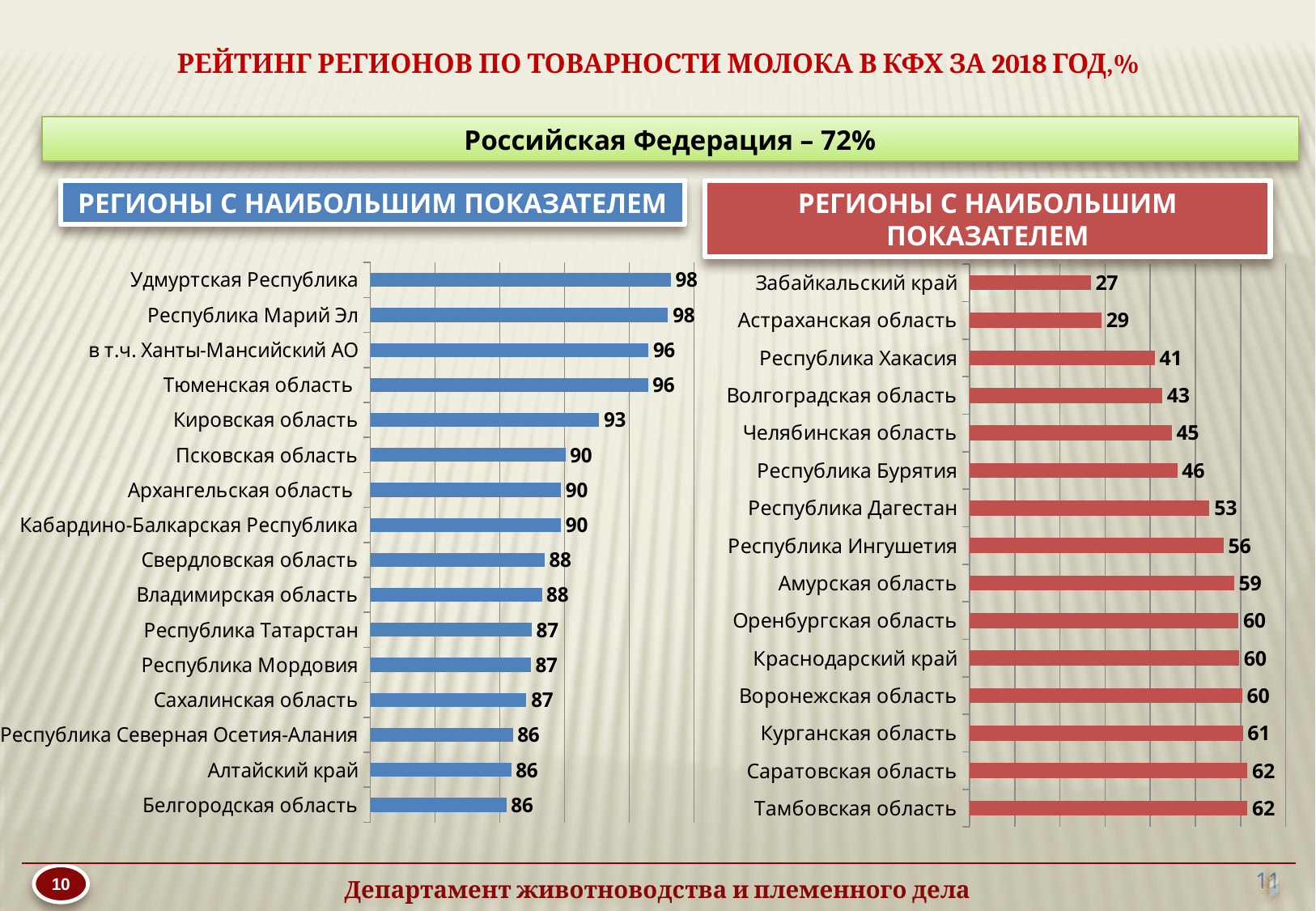
On the right chart, which region has the lowest value? Забайкальский край On the left chart, what is the difference between the values for Удмуртская Республика and Белгородская область? 12 What type of chart is the left chart? Bar chart On the left chart, what is the value for Кировская область? 93 On the left chart, which is larger: the value for Псковская область or the value for Республика Татарстан? Псковская область On the right chart, what is the difference between the values for Тамбовская область and Астраханская область? 33 What value is given for the Российская Федерация on the slide? 72% How many regions are shown on the right chart? 15 On the right chart, which is larger: the value for Республика Хакасия or the value for Амурская область? Амурская область On the right chart, what is the value for Республика Дагестан? 53 On the left chart, what is the value for Тюменская область? 96 How many regions are shown on the left chart? 16